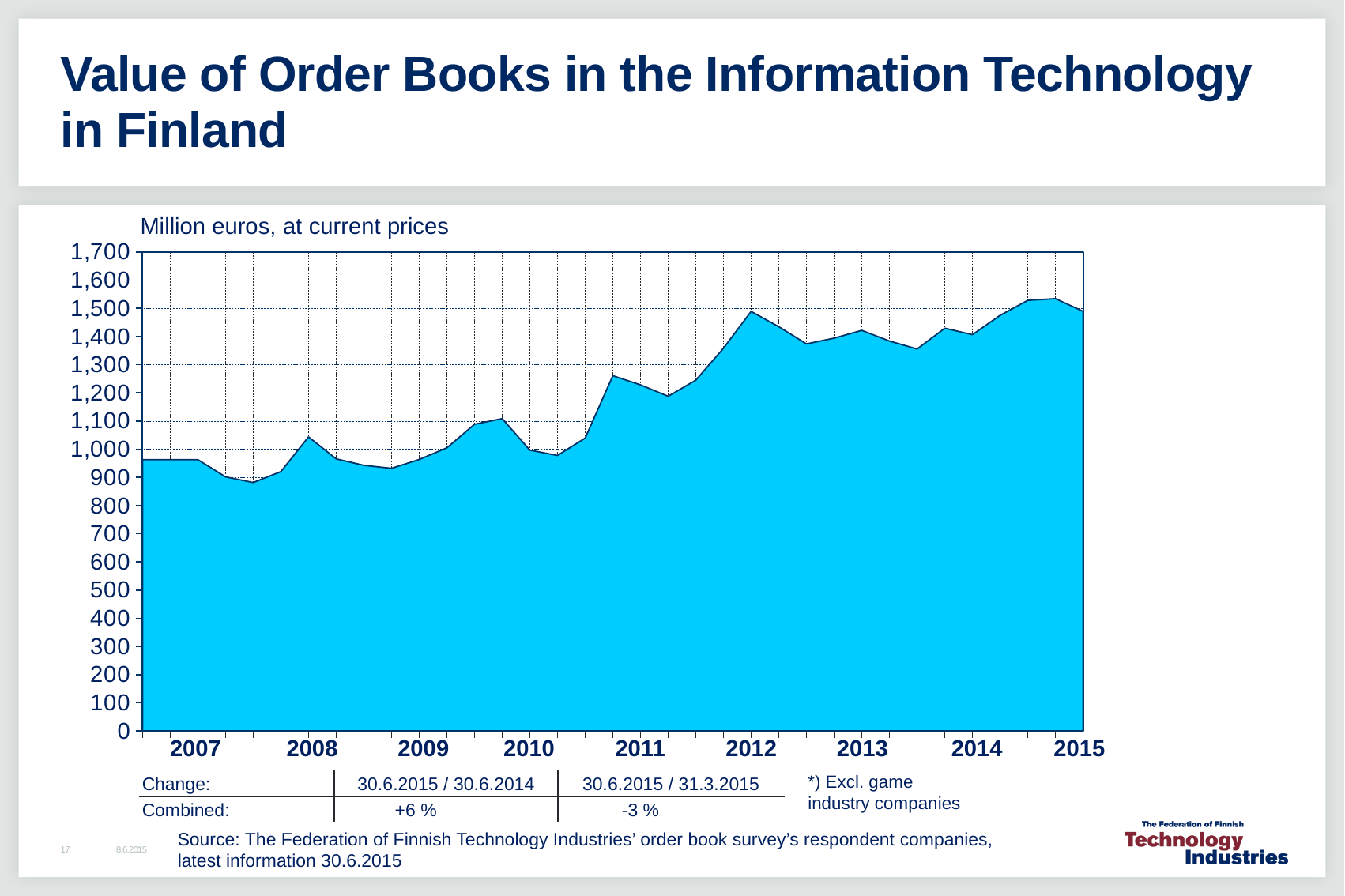
Is the value of order books at the start of 2009 greater or less than 1,000? less Which is larger, the value of order books at 2015 or at the start of 2007? 2015 What kind of chart is shown on the slide? area chart Is the value of order books at 2015 greater or less than 1,400? greater Is the value of order books at the start of 2013 greater or less than 1,300? greater In what unit are the values on the chart expressed? Million euros, at current prices Overall, do the values of order books rise or fall from 2007 to 2015? rise How many years are labelled on the x axis of the chart? 9